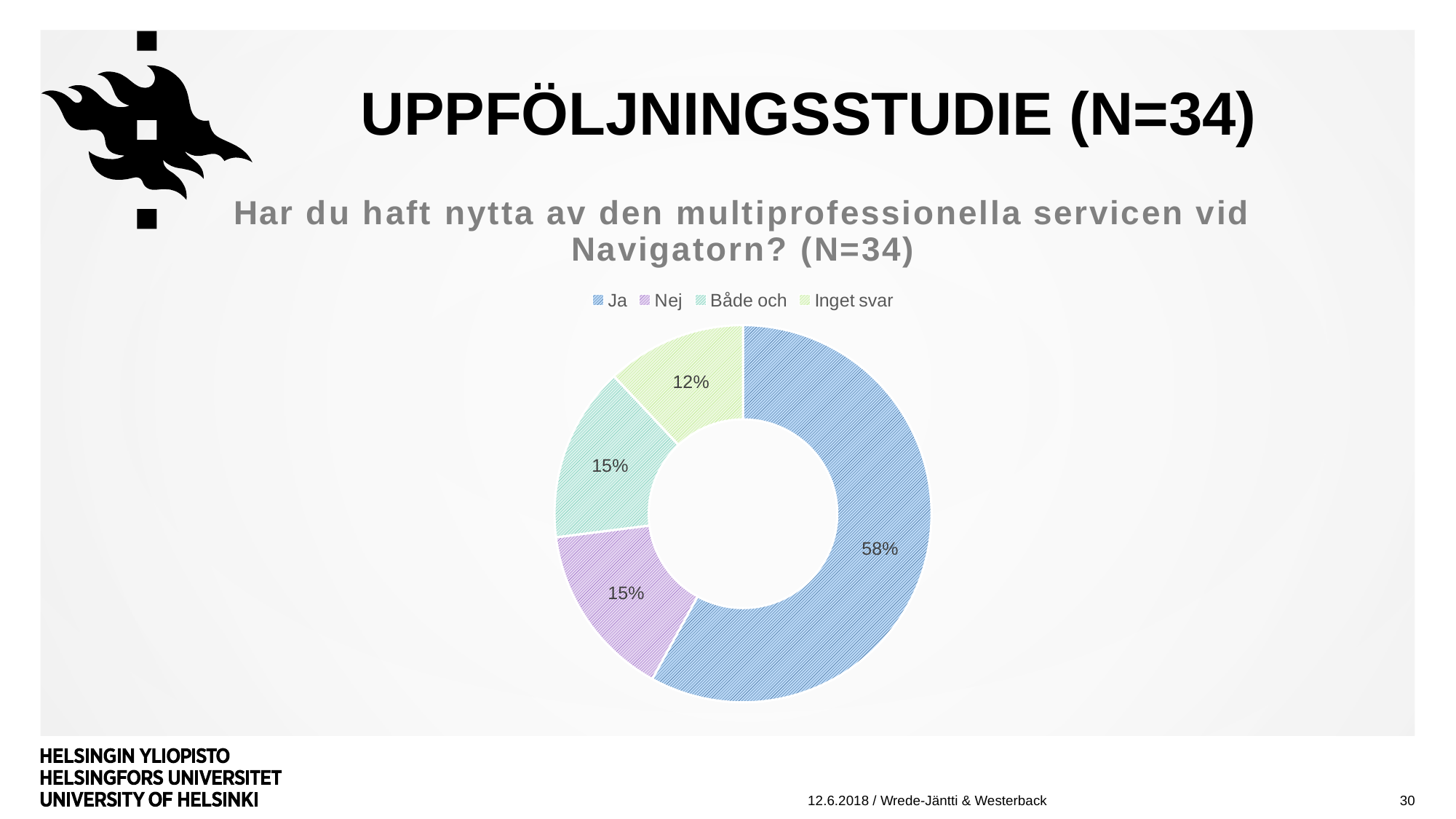
Which answer category has the largest share? Ja What share of respondents answered "Både och"? 15% Which is larger, the share for "Ja" or the share for "Inget svar"? Ja What kind of chart is shown on the slide? Doughnut (pie) chart How many answer categories does the legend list? 4 What is the title of the chart? Har du haft nytta av den multiprofessionella servicen vid Navigatorn? (N=34) What share of respondents gave "Inget svar"? 12% What colour is the "Ja" segment in the chart? Blue What is the difference in percentage points between "Ja" and "Nej"? 43 percentage points Which answer category has the smallest share? Inget svar What share of respondents answered "Nej"? 15% What share of respondents answered "Ja"? 58%